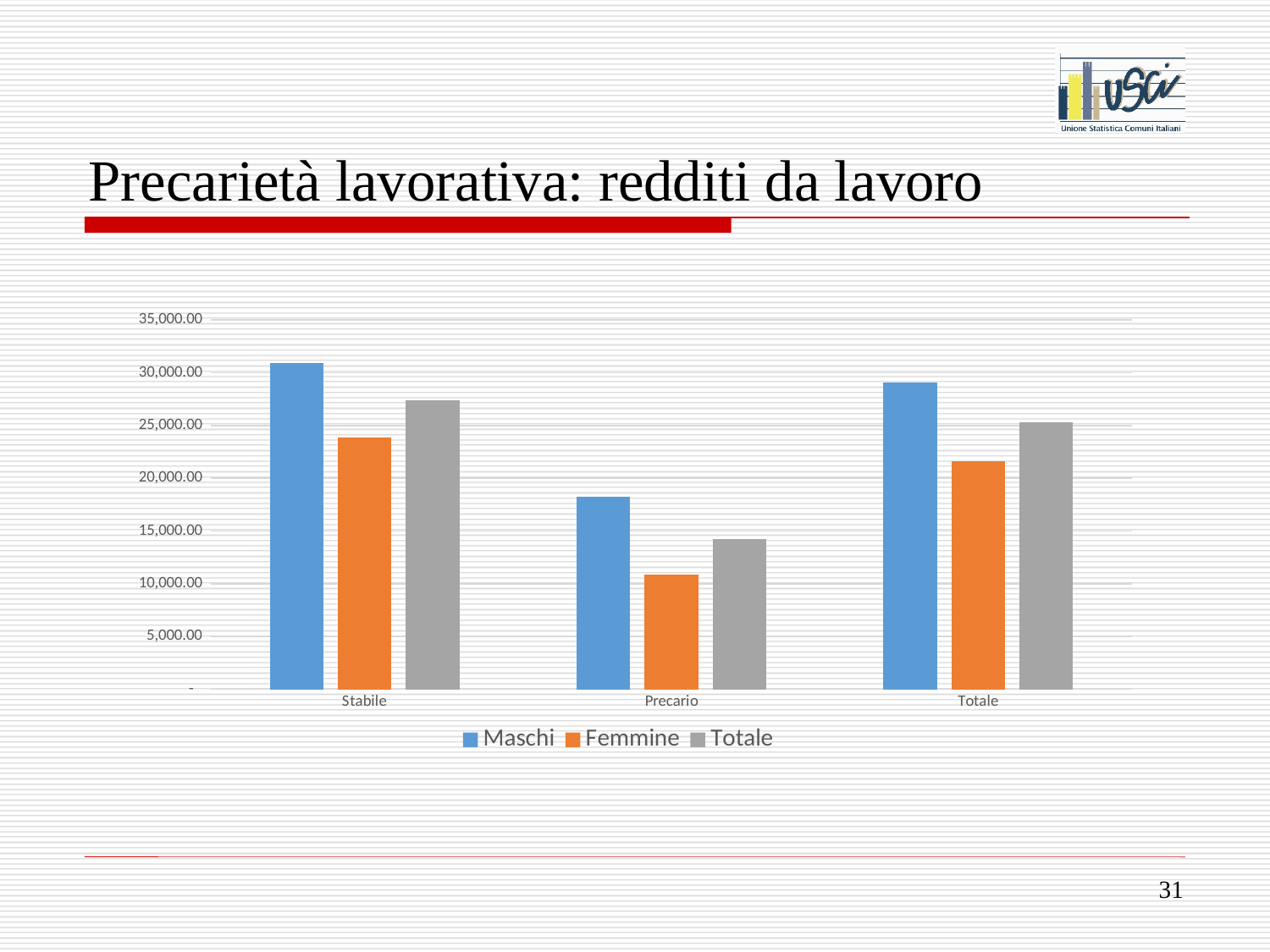
Which category has the highest Maschi value? Stabile Which is larger, the Femmine value for Stabile or the Femmine value for Totale? Stabile What kind of chart is shown on the slide? bar chart How many categories are shown on the x axis of the chart? 3 Is the Femmine value for Precario greater or less than 15,000.00? less Which category has the lowest Femmine value? Precario Which is larger, the Maschi value for Precario or the Totale series value for Stabile? Totale series value for Stabile Within the Precario category, which series has the lowest value? Femmine What is the title of the slide containing the chart? Precarietà lavorativa: redditi da lavoro Is the Maschi value for Stabile greater or less than 30,000.00? greater How many series does the chart's legend list? 3